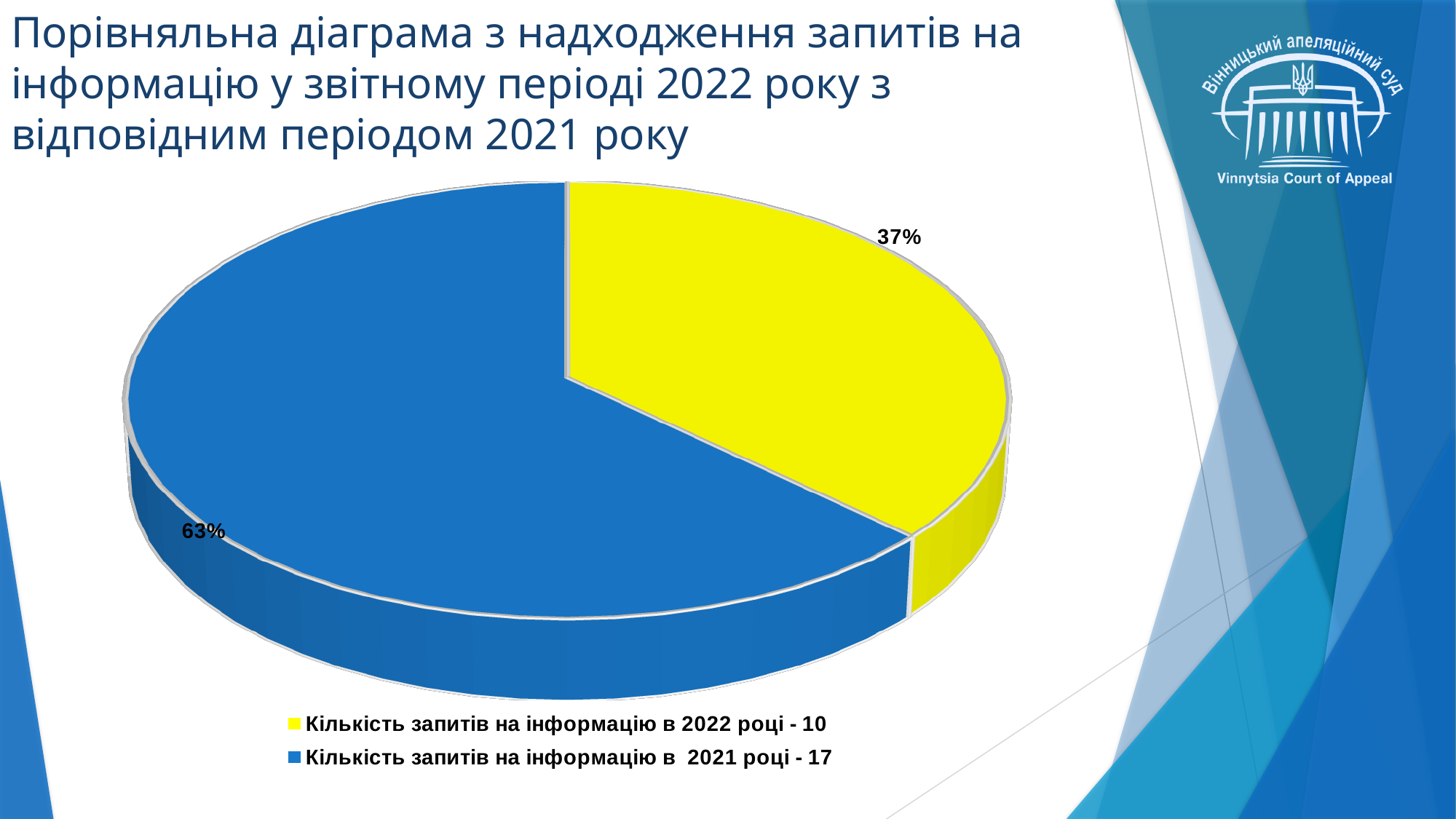
Which slice is the smallest in the pie chart? Кількість запитів на інформацію в 2022 році What percentage share is shown for the 2021 slice (Кількість запитів на інформацію в 2021 році)? 63% What kind of chart is shown on the slide? pie chart According to the legend, how many information requests were received in 2022? 10 How many entries does the legend list? 2 What is the difference in percentage points between the 2021 slice and the 2022 slice? 26% What percentage share is shown for the 2022 slice (Кількість запитів на інформацію в 2022 році)? 37% Which year has the larger slice of the pie, 2022 or 2021? 2021 What colour is the slice representing 2021 requests? blue What colour is the slice representing 2022 requests? yellow How many slices does the pie chart have? 2 According to the legend, how many information requests were received in 2021? 17